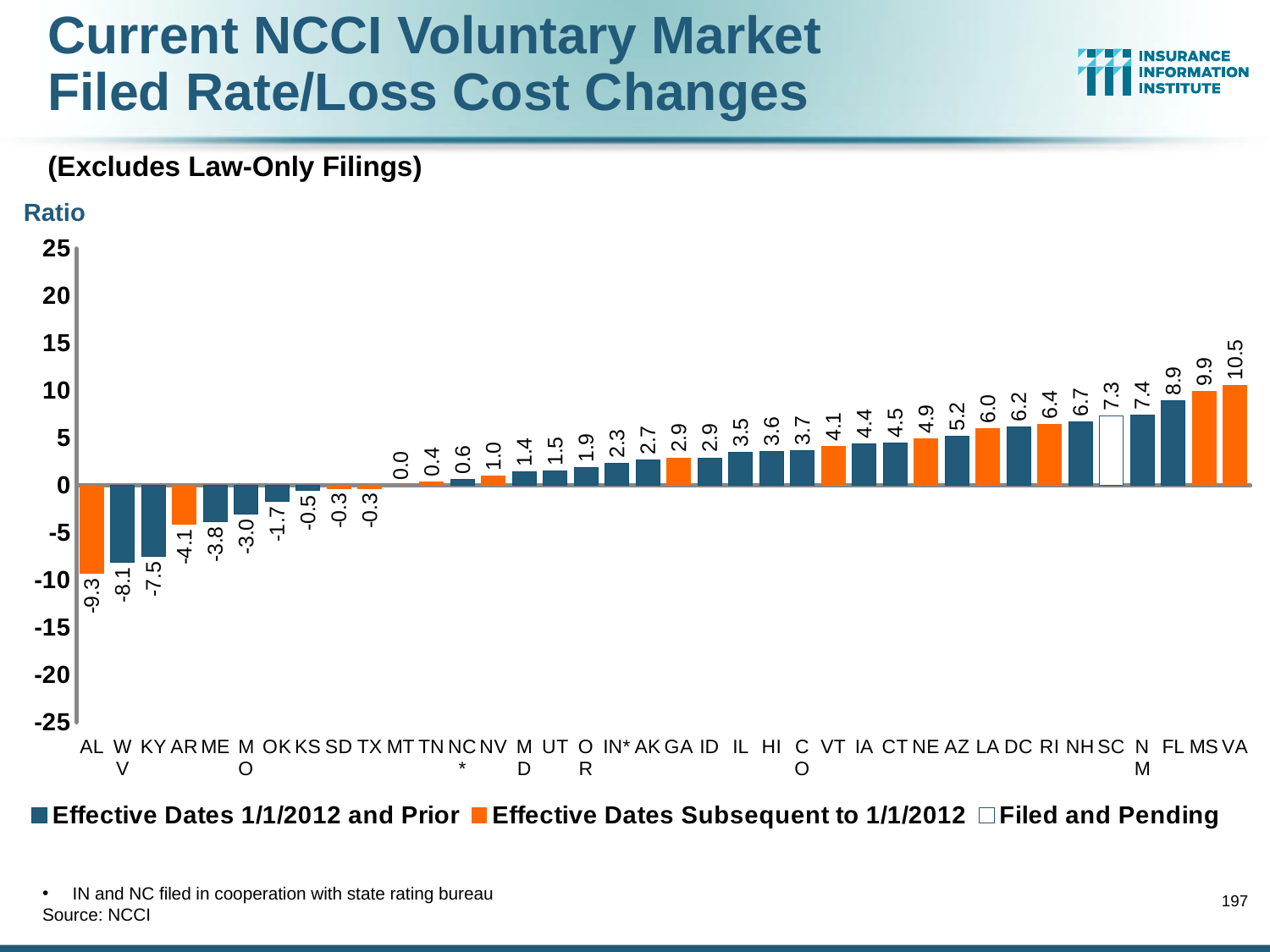
Do the values rise or fall moving from left to right along the x axis? Rise What is the difference between the values for VA and MS? 0.6 Which state has the lowest value? AL What is the value for VA? 10.5 What is the value for SC? 7.3 Which has a larger value, FL or NH? FL How many series does the legend list? 3 Which state's bar belongs to the 'Filed and Pending' series? SC How many states or jurisdictions are shown on the x axis? 38 What kind of chart is this? Bar chart What is the value for AL? -9.3 Which state has the highest value? VA